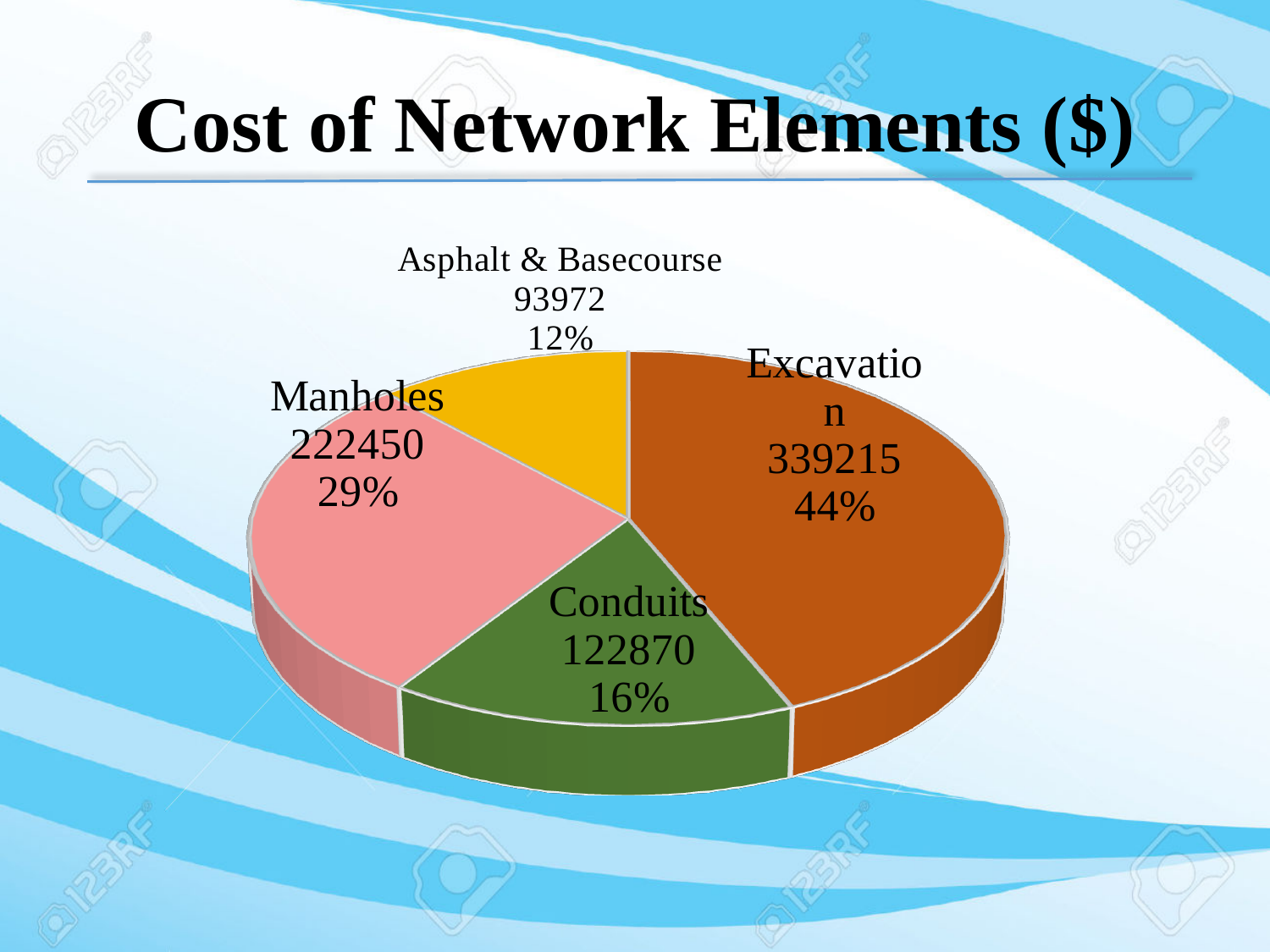
What is the cost of Asphalt & Basecourse? 93972 What share of the pie does Manholes represent? 29% What is the difference in cost between Excavation and Manholes? 116765 What share of the pie does Conduits represent? 16% What is the cost of Excavation? 339215 How many slices does the pie chart have? 4 What is the cost of Manholes? 222450 Which costs more, Conduits or Asphalt & Basecourse? Conduits Which network element has the highest cost? Excavation What is the cost of Conduits? 122870 Which network element has the lowest cost? Asphalt & Basecourse What kind of chart is shown on the slide? Pie chart